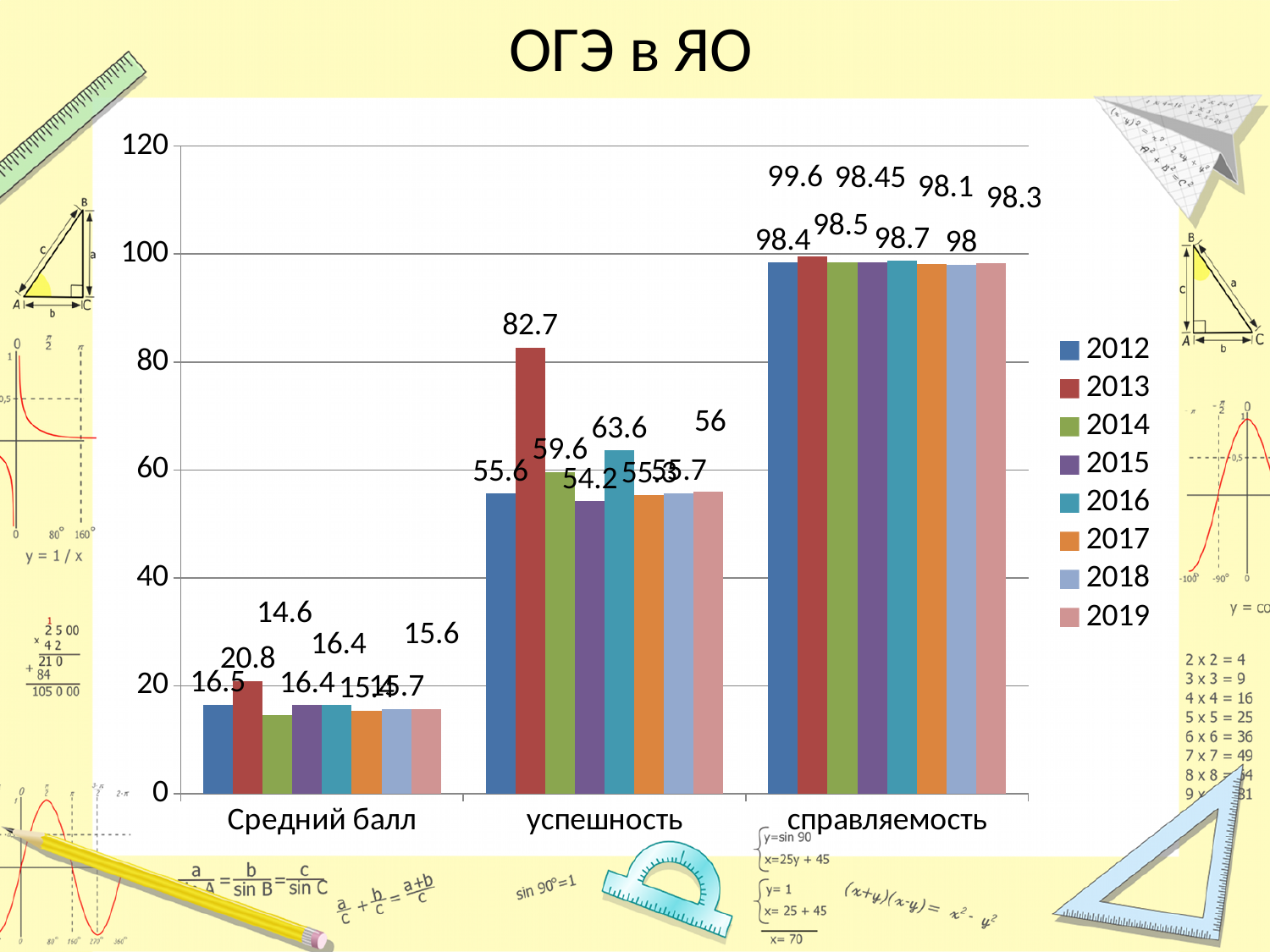
What kind of chart is shown on the slide? bar chart Which year has the highest value in the успешность category? 2013 How many categories are shown on the x axis? 3 What is the value for 2015 in the справляемость category? 98.45 In the успешность category, which is larger: the value for 2014 or the value for 2015? 2014 Which year has the lowest value in the Средний балл category? 2014 How many series does the legend list? 8 Is the value for 2013 in the успешность category greater or less than 80? greater What is the value for 2013 in the успешность category? 82.7 What is the difference between the 2013 and 2012 values in the успешность category? 27.1 What is the value for 2013 in the Средний балл category? 20.8 What is the value for 2016 in the успешность category? 63.6